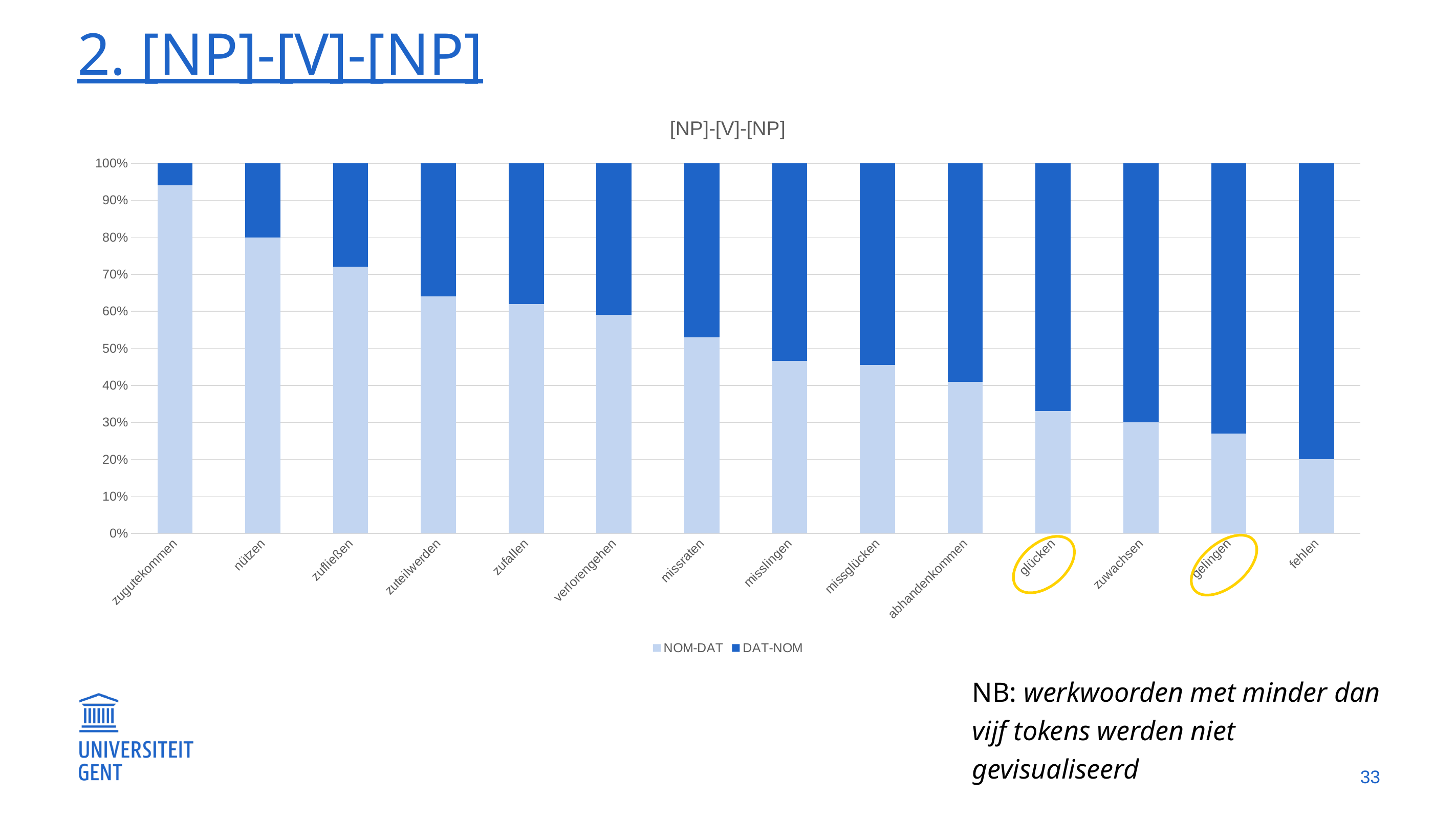
What are the two series named in the legend? NOM-DAT and DAT-NOM Which verb has a larger NOM-DAT share, zufließen or missraten? zufließen Is the NOM-DAT share for zugutekommen greater or less than 90%? greater Which verb has the lowest NOM-DAT share? fehlen What kind of chart is shown on the slide? stacked bar chart Does the NOM-DAT share rise or fall moving from left to right along the x axis? fall What is the title of the chart? [NP]-[V]-[NP] How many verbs (categories) are shown on the x axis of the chart? 14 Which verb has the highest DAT-NOM share? fehlen Which verb has the highest NOM-DAT share? zugutekommen How many series does the legend of the chart list? 2 Is the NOM-DAT share for abhandenkommen greater or less than 50%? less